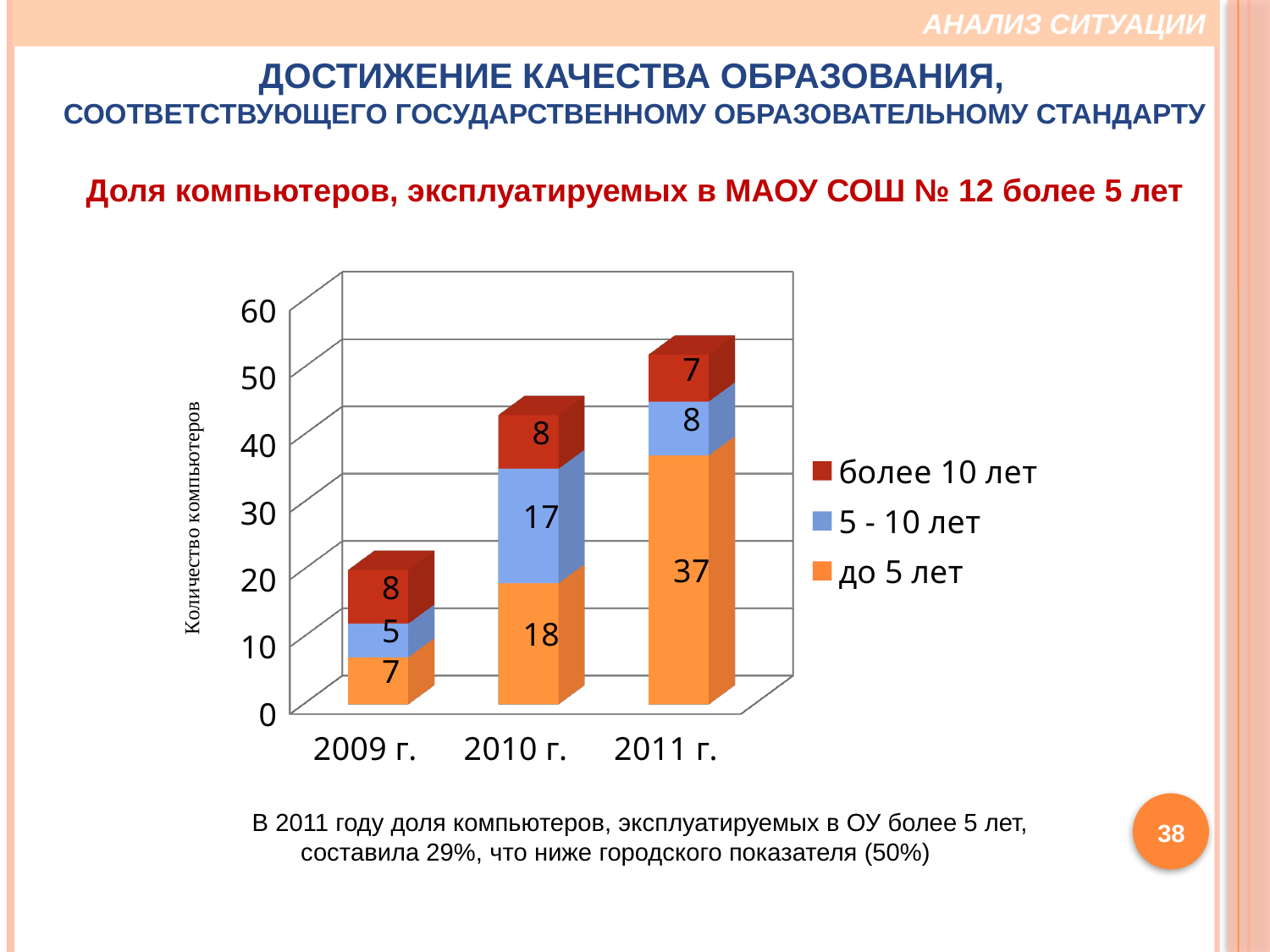
How many years (categories) are shown on the x axis? 3 What is the value for "5 - 10 лет" in 2010 г.? 17 What is the difference between the "до 5 лет" values for 2011 г. and 2010 г.? 19 What is the total of the stacked bar for 2011 г.? 52 What is the value for "более 10 лет" in 2009 г.? 8 Does the total number of computers rise or fall from 2009 г. to 2011 г.? Rises Which year has the highest value for "до 5 лет"? 2011 г. What is the total of the stacked bar for 2010 г.? 43 Which year has the lowest total number of computers? 2009 г. What is the value for "до 5 лет" in 2011 г.? 37 How many series does the legend list? 3 What kind of chart is shown on the slide? Stacked bar chart